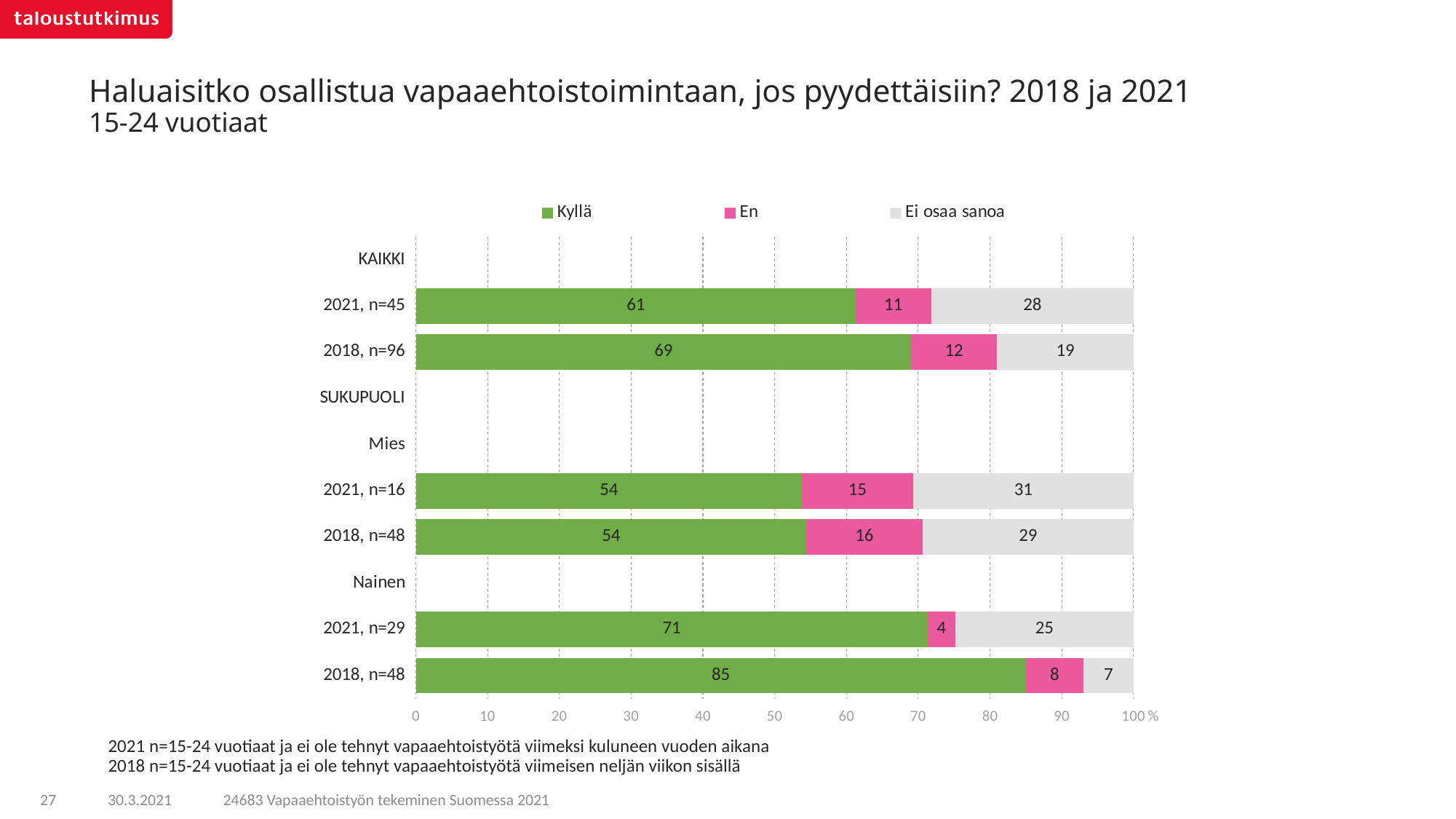
Which bar has the highest Kyllä value? Nainen 2018, n=48 What is the difference between the Kyllä values for Nainen 2018, n=48 and Nainen 2021, n=29? 14 How many series does the legend list? 3 Which series is shown in pink in the legend? En How many data bars are plotted in the chart? 6 Which bar has the lowest En value? Nainen 2021, n=29 What is the Ei osaa sanoa value for Nainen 2018, n=48? 7 What is the total of the stacked bar for KAIKKI 2018, n=96? 100 Which is larger: the Ei osaa sanoa value for Mies 2021, n=16 or for KAIKKI 2021, n=45? Mies 2021, n=16 What kind of chart is shown on the slide? Stacked bar chart What is the En value for Mies 2018, n=48? 16 What is the Kyllä value for KAIKKI 2021, n=45? 61